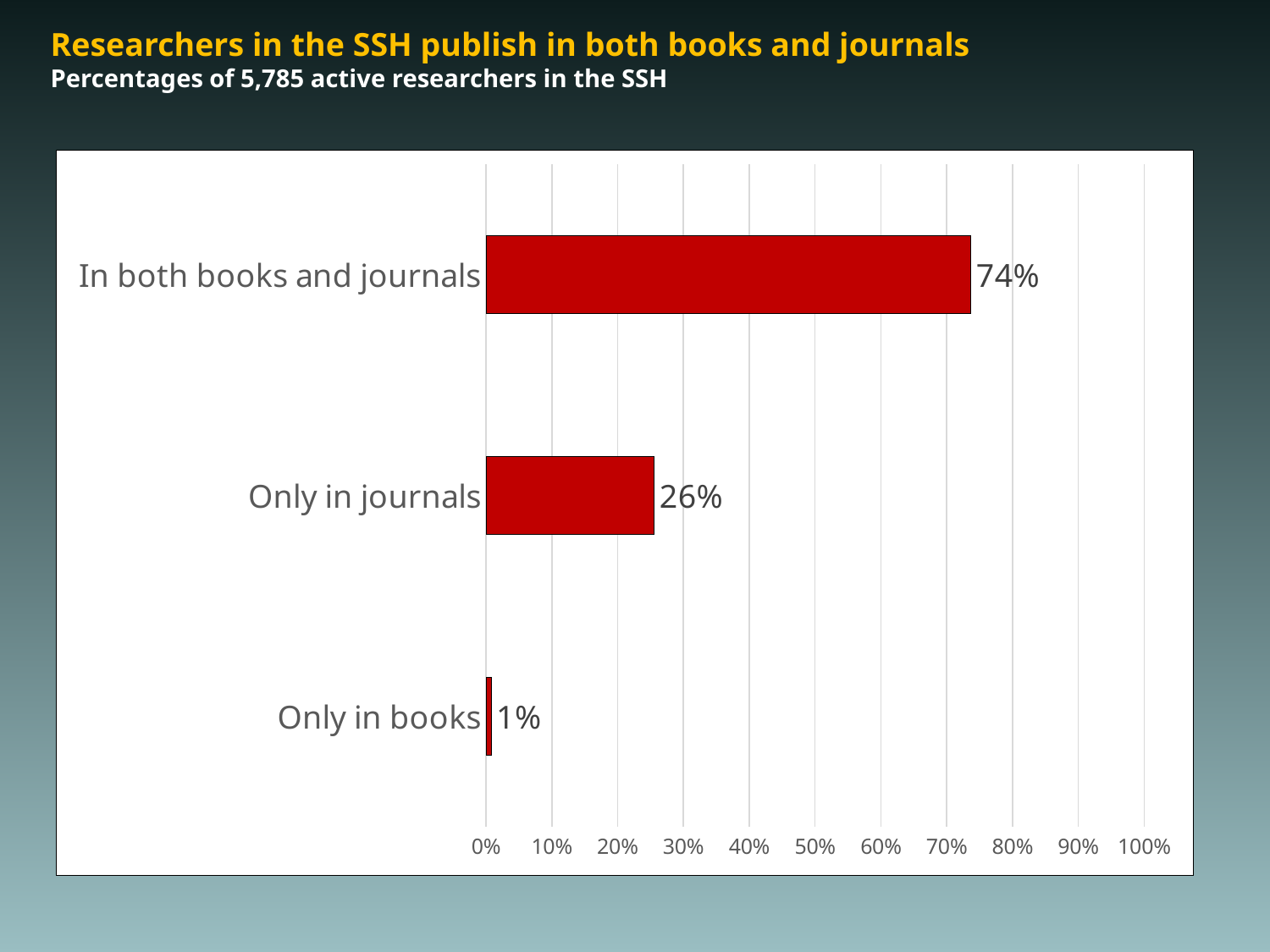
How many active researchers in the SSH does the subtitle say the percentages are based on? 5,785 What is the difference in percentage points between 'Only in journals' and 'Only in books'? 25 What percentage of researchers publish only in books? 1% What percentage of researchers publish in both books and journals? 74% What is the difference in percentage points between 'In both books and journals' and 'Only in journals'? 48 Which category has the highest percentage? In both books and journals How many categories are shown in the chart? 3 Which is larger: the percentage for 'Only in journals' or 'Only in books'? Only in journals Is the value for 'In both books and journals' greater or less than 70%? greater What type of chart is shown on the slide? Bar chart What percentage of researchers publish only in journals? 26% Which category has the lowest percentage? Only in books